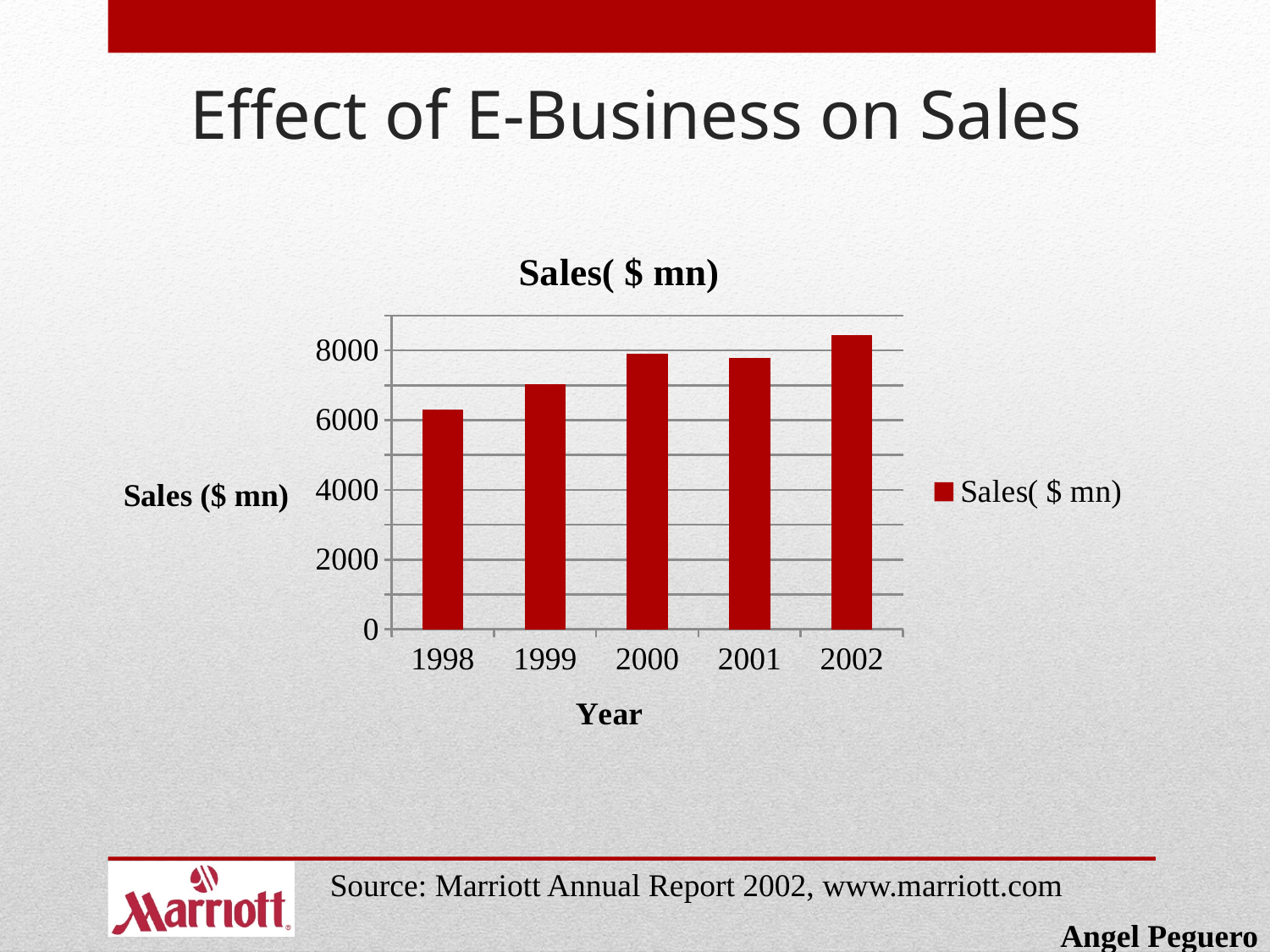
How many years are shown on the x axis of the chart? 5 Is the value for 2002 greater or less than 8000? greater Which year has larger sales, 1998 or 1999? 1999 Is the value for 1998 greater or less than 6000? greater Which year has the lowest sales in the chart? 1998 Which year has the highest sales in the chart? 2002 Is the value for 1999 greater or less than 8000? less What kind of chart is shown on the slide? bar chart What is the title of the chart? Sales( $ mn) Which year has larger sales, 2001 or 2002? 2002 How many series does the chart's legend list? 1 What is the title of the x axis of the chart? Year